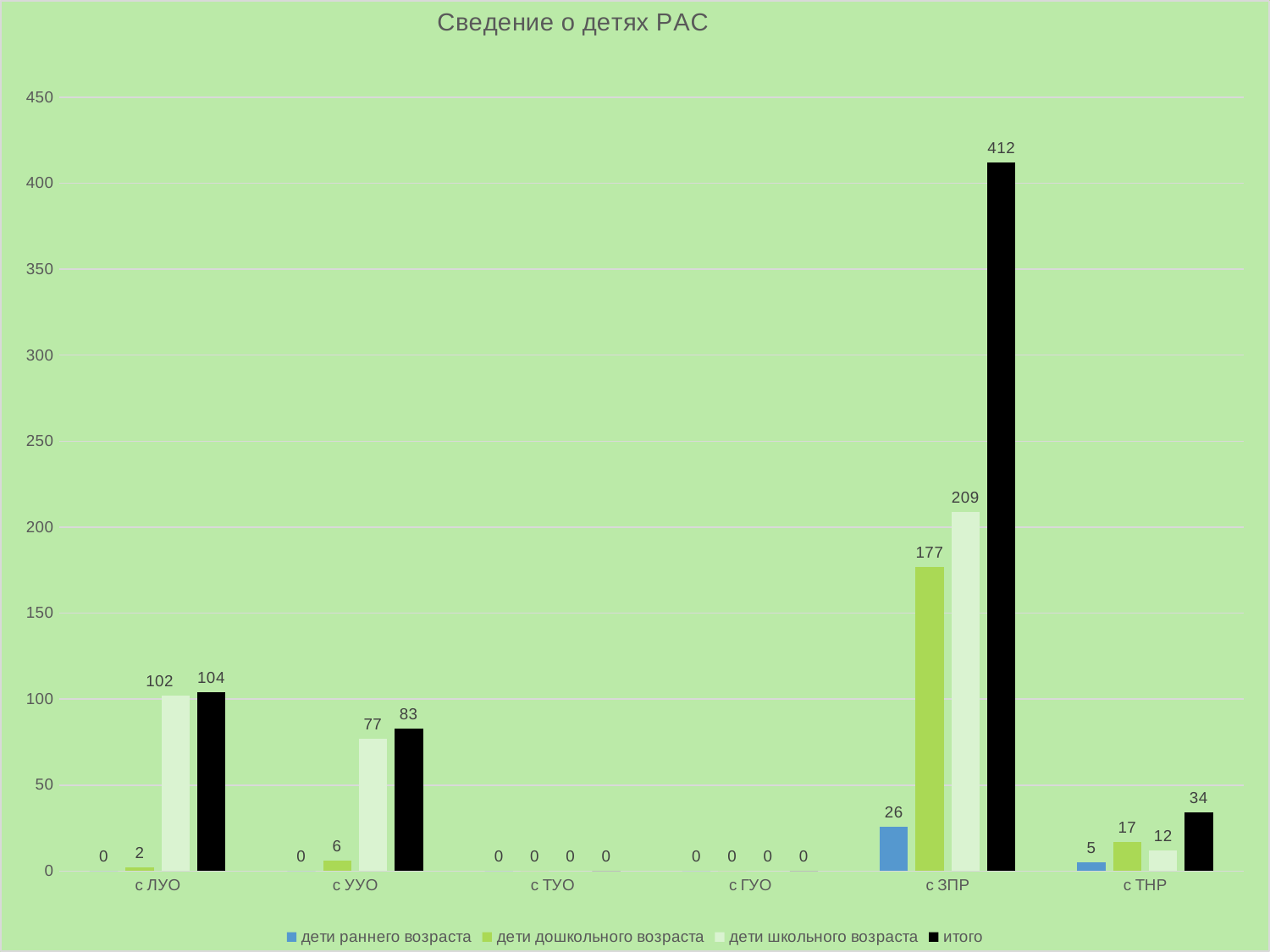
Is the 'итого' value for 'с ЗПР' greater or less than 400? greater How many series does the legend list? 4 Which category has the highest 'итого' value? с ЗПР What is the value of 'дети раннего возраста' for 'с ЗПР'? 26 What is the value of 'итого' for 'с ЗПР'? 412 What is the value of 'дети школьного возраста' for 'с ЛУО'? 102 What is the difference between 'дети школьного возраста' and 'дети дошкольного возраста' for 'с ЗПР'? 32 What is the title of the chart? Сведение о детях РАС What is the value of 'дети дошкольного возраста' for 'с ТНР'? 17 What kind of chart is shown on the slide? bar chart Which is larger: 'итого' for 'с ЛУО' or 'итого' for 'с УУО'? с ЛУО How many categories are shown on the x axis? 6